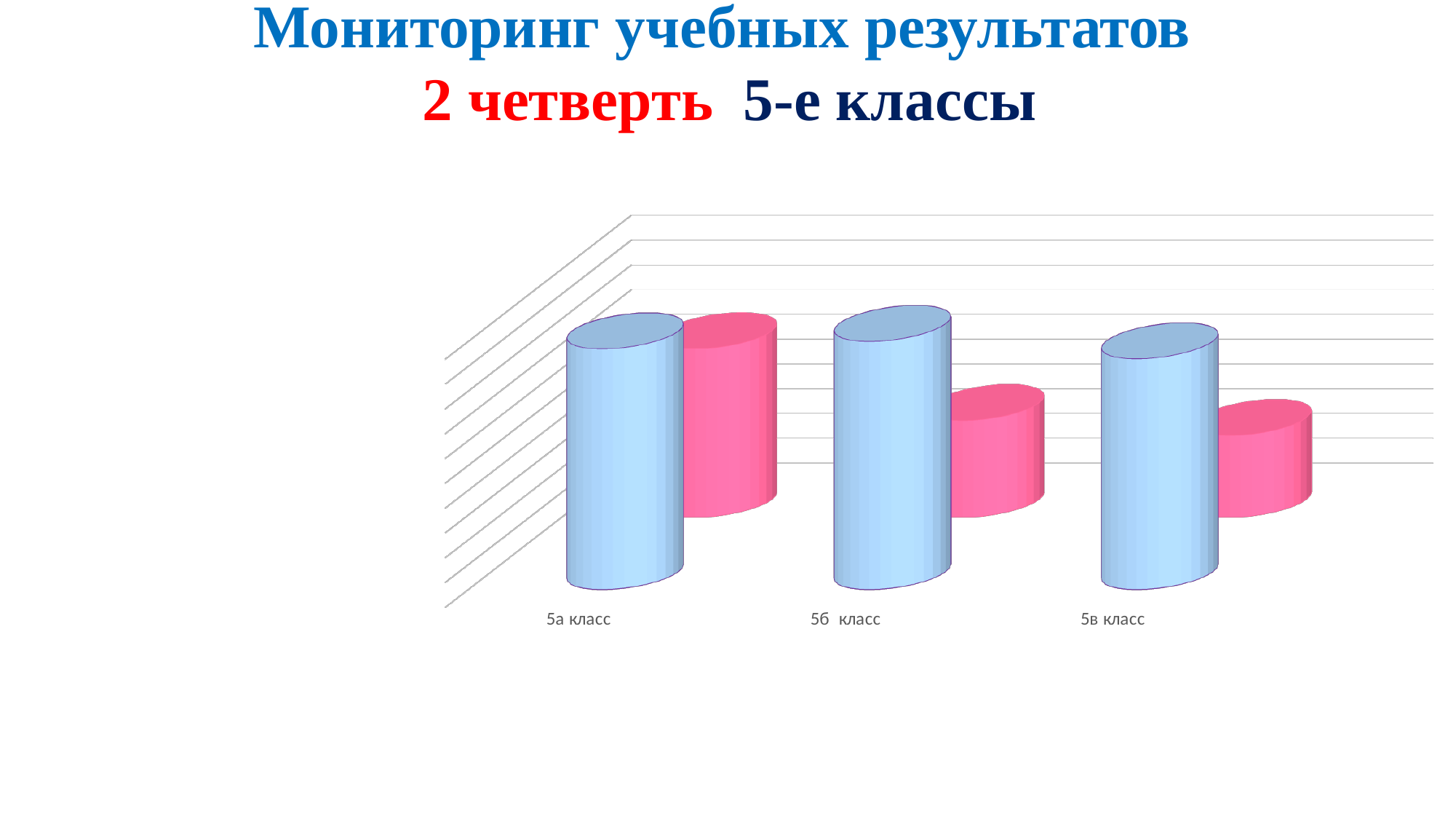
For 5б класс, which bar is taller, the blue one or the pink one? the blue one For 5в класс, which bar is taller, the blue one or the pink one? the blue one How many bars are plotted for each class in the chart? 2 How many classes (categories) are shown on the x axis of the chart? 3 What kind of chart is shown on the slide? bar chart Is the blue bar for 5б класс taller or shorter than the blue bar for 5в класс? taller What is the title of the slide containing the chart? Мониторинг учебных результатов 2 четверть 5-е классы What two colours are used for the bars in the chart? blue and pink Which class has the shortest blue bar? 5в класс Which class has the tallest pink bar? 5а класс